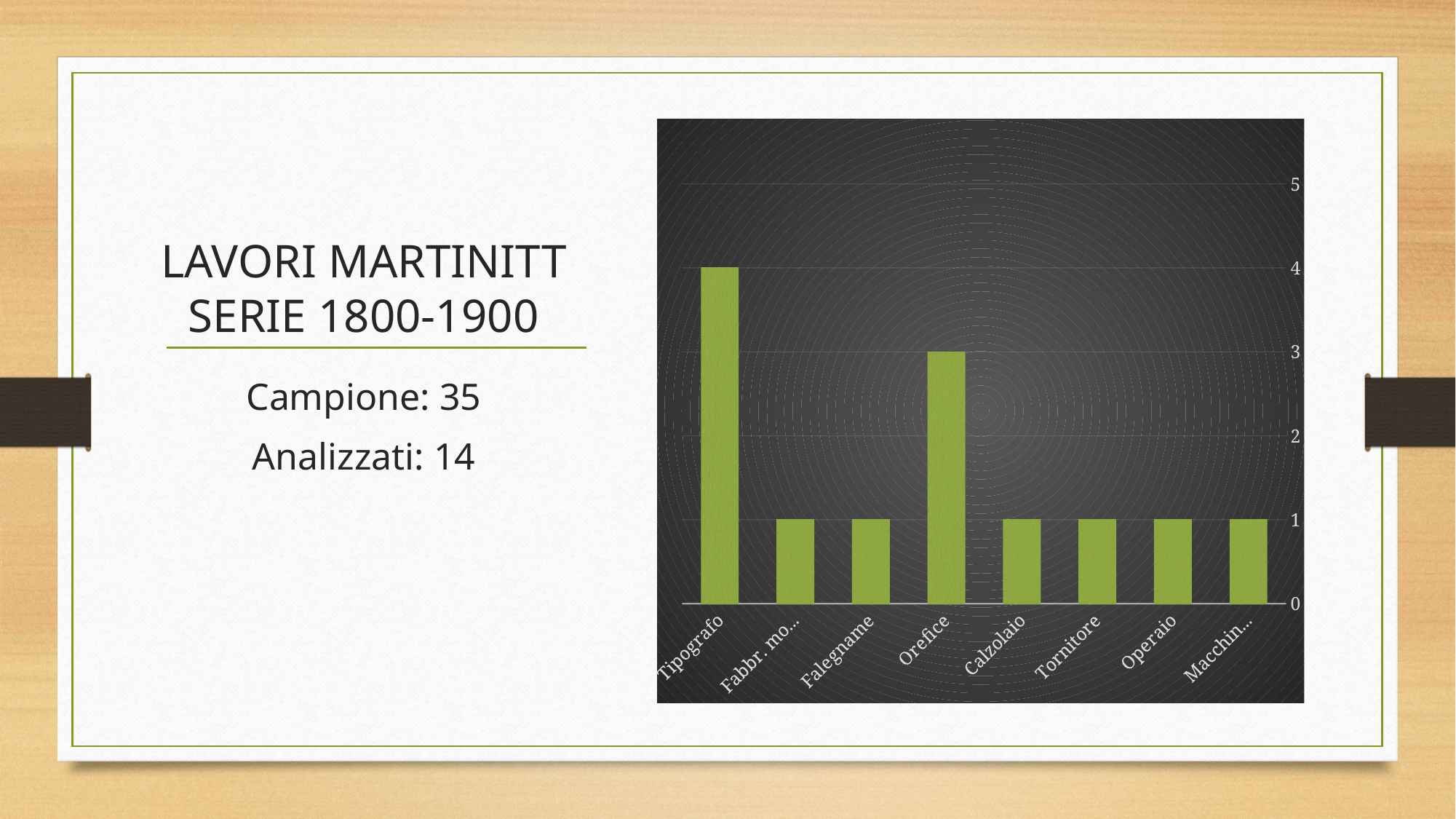
What kind of chart is shown on the slide? Bar chart Which is larger, the value for Orefice or the value for Operaio? Orefice What is the value for Tipografo? 4 How many categories are shown on the x axis? 8 What is the difference between the values for Orefice and Calzolaio? 2 Which category has the highest value? Tipografo What is the value for Orefice? 3 What colour are the bars in the chart? Green What is the difference between the values for Tipografo and Orefice? 1 What is the value for Falegname? 1 Which is larger, the value for Tipografo or the value for Orefice? Tipografo What is the value for Tornitore? 1